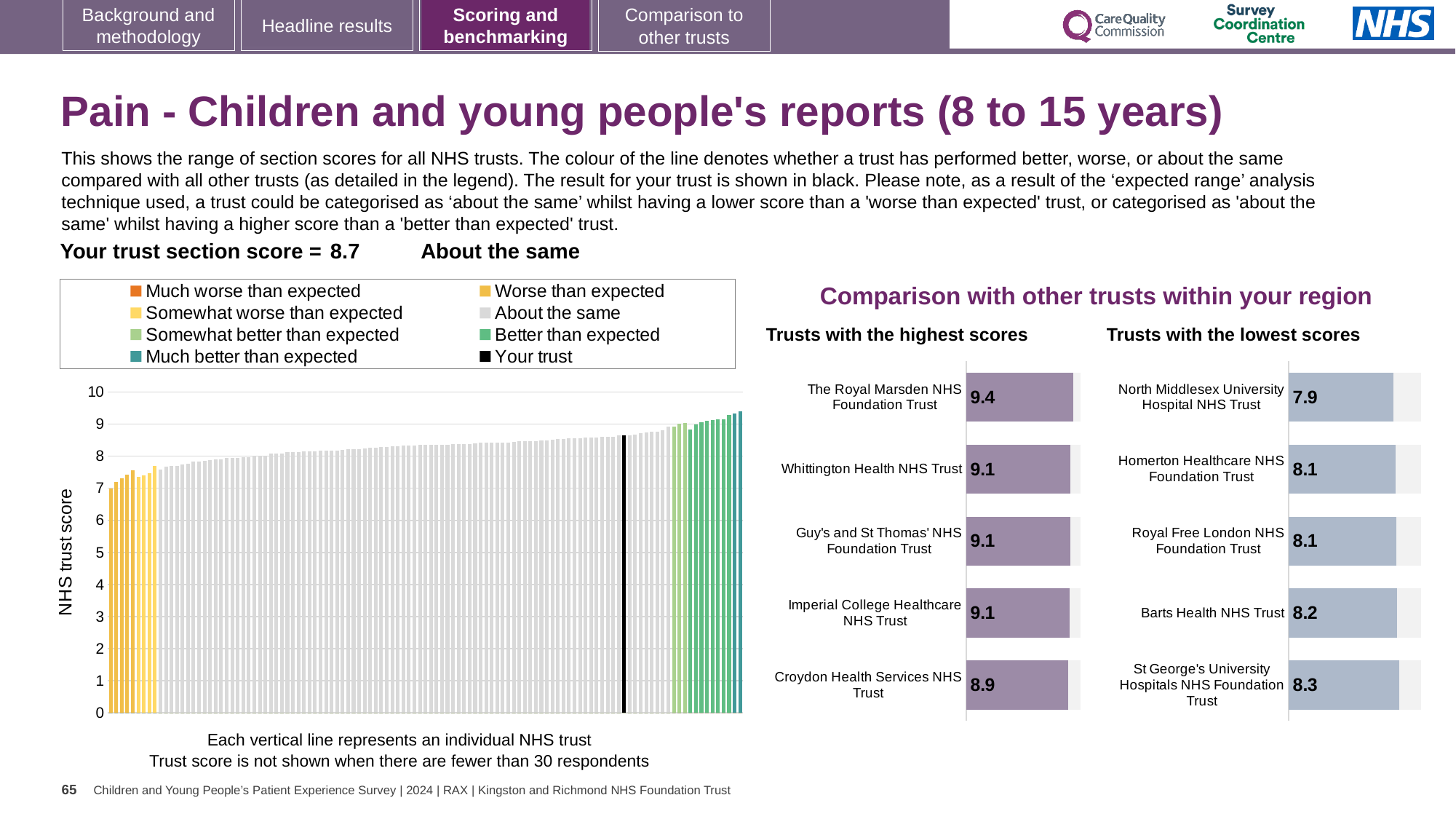
In the 'NHS trust score' chart on the left, is the value of the black 'Your trust' bar greater or less than 8? greater In the 'Trusts with the highest scores' chart, which trust has the highest score? The Royal Marsden NHS Foundation Trust What kind of chart is the 'NHS trust score' chart on the left of the slide? Bar chart In the 'NHS trust score' chart on the left, do the bar values rise or fall from left to right? Rise In the 'Trusts with the highest scores' chart, what is the score for The Royal Marsden NHS Foundation Trust? 9.4 In the 'Trusts with the lowest scores' chart, what is the score for North Middlesex University Hospital NHS Trust? 7.9 In the 'Trusts with the highest scores' chart, what is the difference between the scores of The Royal Marsden NHS Foundation Trust and Croydon Health Services NHS Trust? 0.5 In the 'Trusts with the lowest scores' chart, which trust has the lowest score? North Middlesex University Hospital NHS Trust How many trusts are shown in the 'Trusts with the highest scores' chart? 5 In the 'Trusts with the lowest scores' chart, what is the difference between the scores of St George's University Hospitals NHS Foundation Trust and North Middlesex University Hospital NHS Trust? 0.4 In the 'Trusts with the lowest scores' chart, which has the higher score: Barts Health NHS Trust or Homerton Healthcare NHS Foundation Trust? Barts Health NHS Trust How many entries does the legend of the 'NHS trust score' chart on the left list? 8